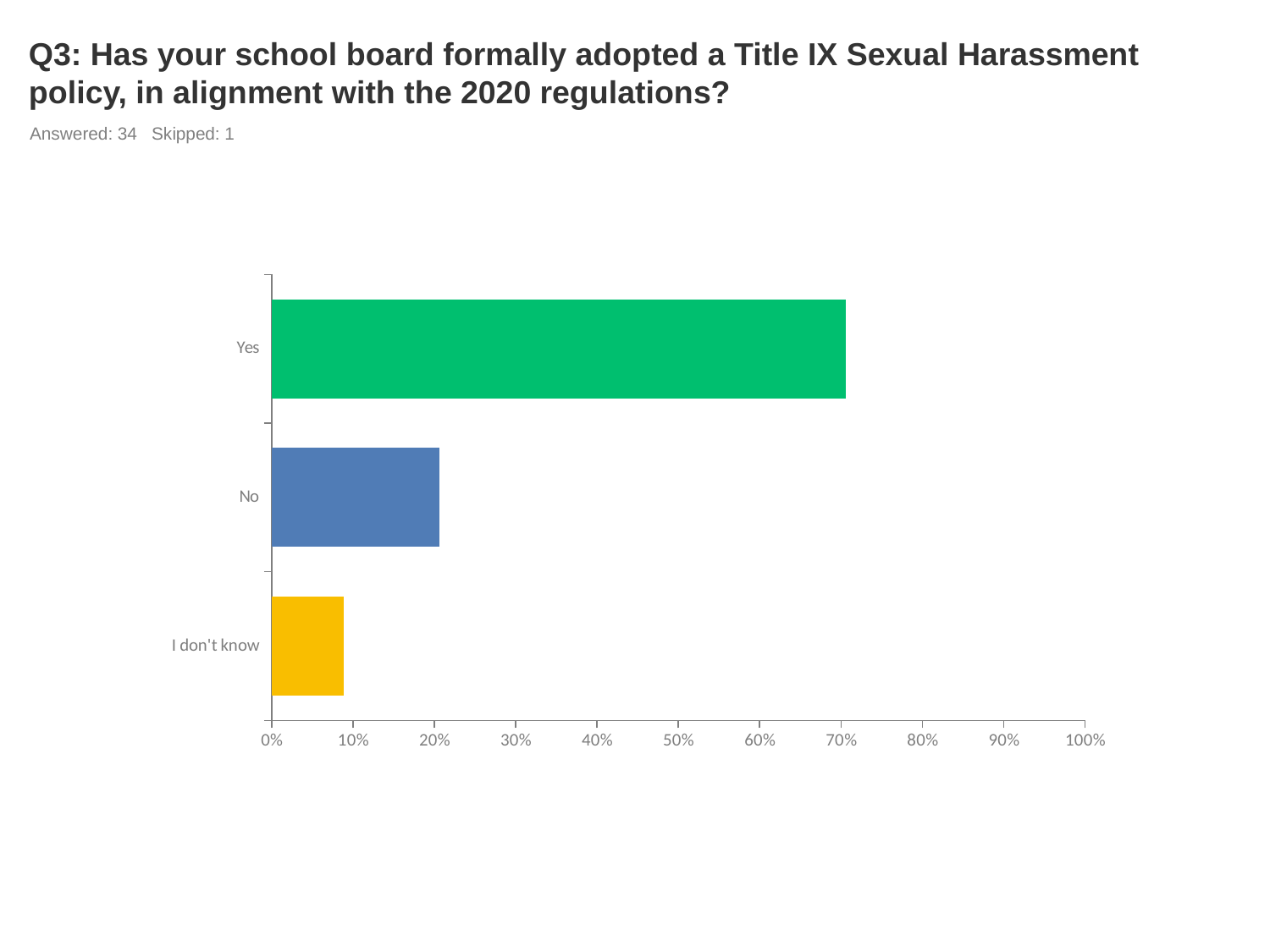
How many respondents answered this question according to the slide? 34 Which category has the lowest value? I don't know What colour is the bar for Yes? green Which category has the highest value? Yes Is the value for No greater or less than 10%? greater Is the value for Yes greater or less than 80%? less How many categories are plotted in the chart? 3 Is the value for No greater or less than 30%? less What kind of chart is shown on the slide? bar chart Which is larger, the value for No or the value for I don't know? No